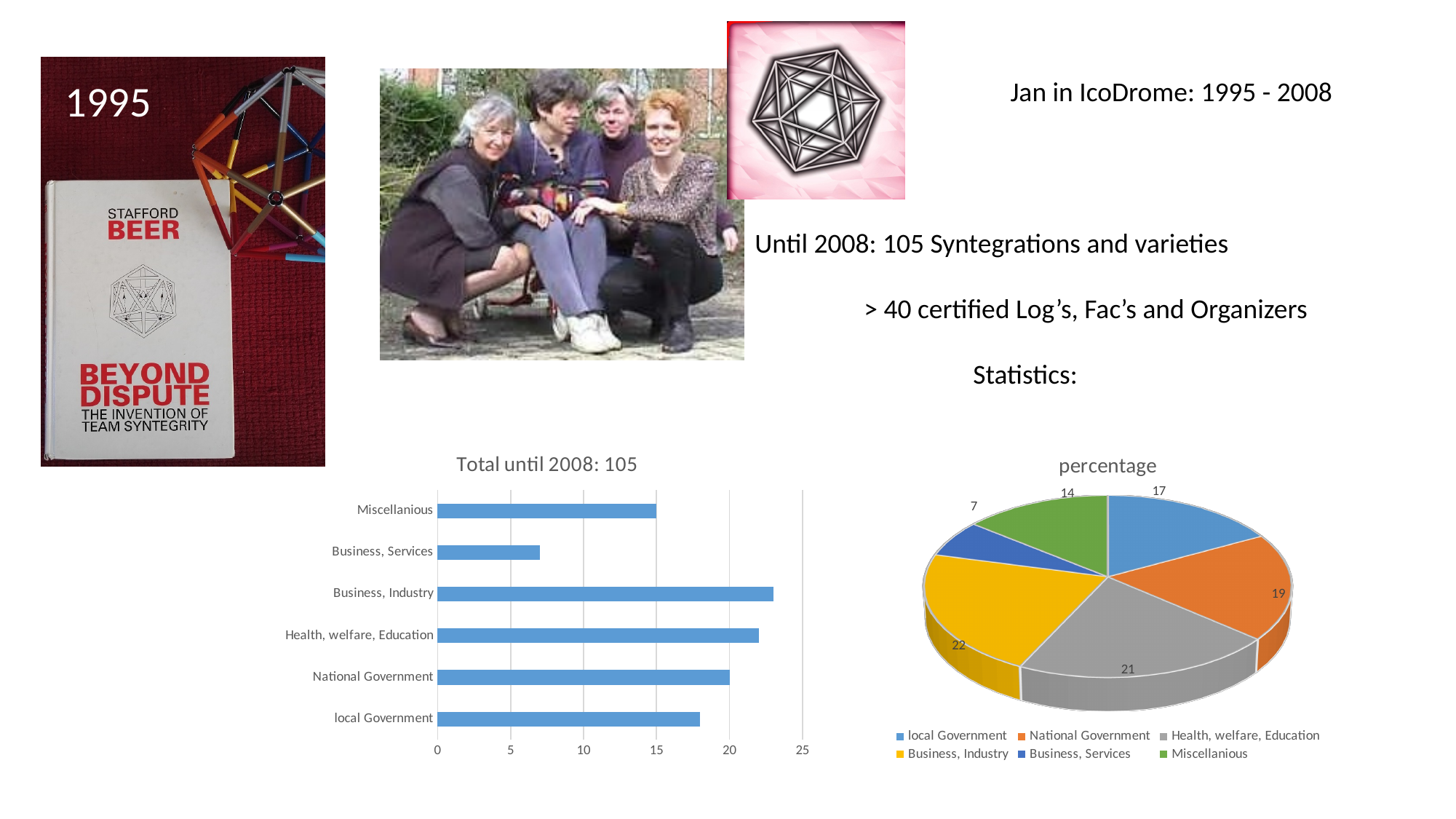
In the "percentage" pie chart, what is the difference between the values for National Government and local Government? 2 In the "Total until 2008: 105" bar chart, which category has the shortest bar? Business, Services What type of chart is the chart titled "Total until 2008: 105"? bar chart How many categories does the "percentage" pie chart legend list? 6 What type of chart is the chart titled "percentage"? pie chart In the "percentage" pie chart, which category has the smallest slice? Business, Services In the "percentage" pie chart, what is the value for Business, Industry? 22 In the "Total until 2008: 105" bar chart, is the value for Business, Industry greater or less than 20? greater In the "percentage" pie chart, what is the value for Business, Services? 7 In the "Total until 2008: 105" bar chart, is the value for Business, Services greater or less than 10? less In the "percentage" pie chart, what is the value for Health, welfare, Education? 21 In the "percentage" pie chart, which category has the largest slice? Business, Industry